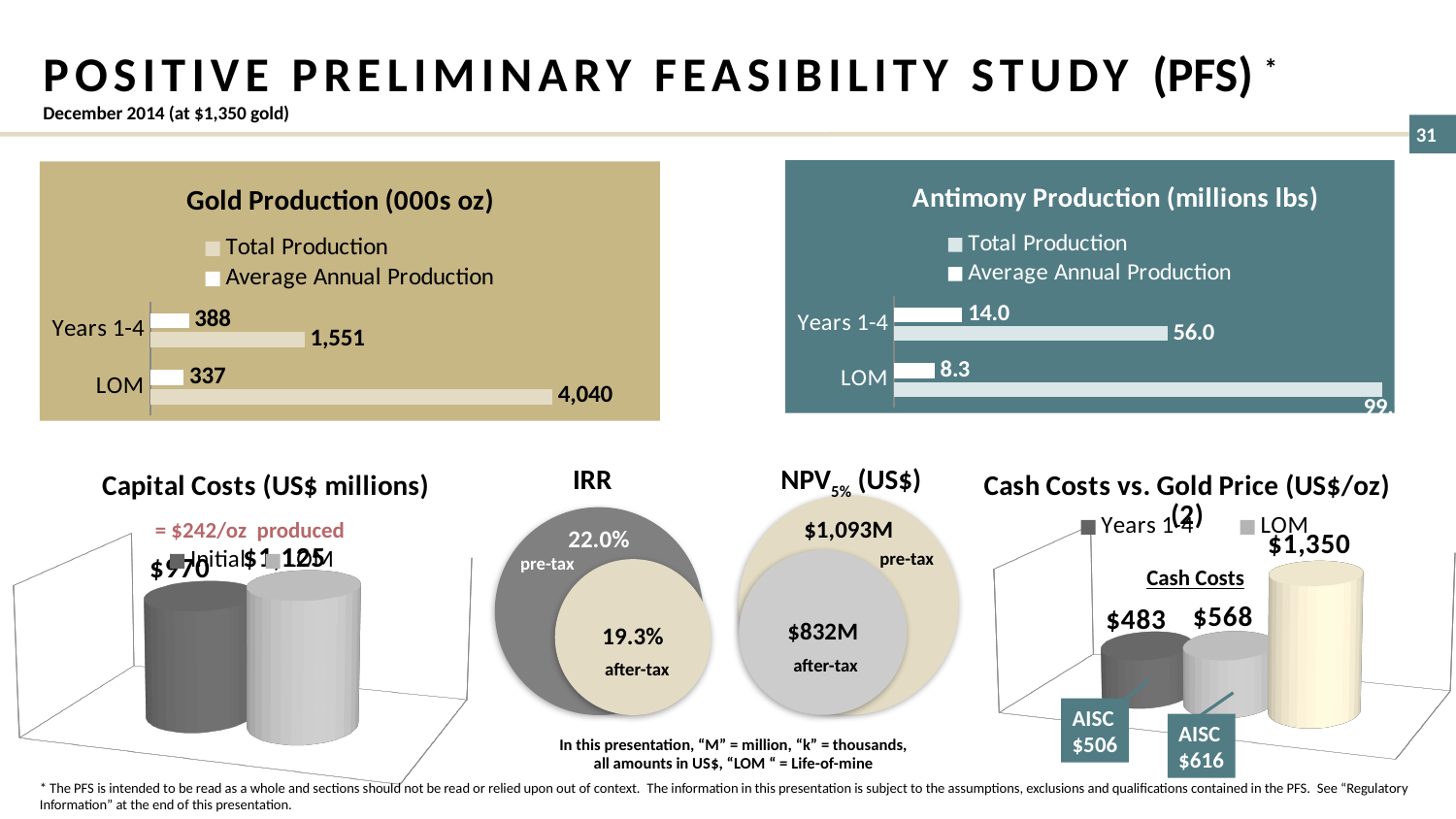
In the Cash Costs vs. Gold Price (US$/oz) chart, what is the LOM cash cost? $568 In the Antimony Production (millions lbs) chart, what is the difference between Average Annual Production for Years 1-4 and for LOM? 5.7 In the Antimony Production (millions lbs) chart, what is the Total Production value for Years 1-4? 56.0 In the IRR chart, what is the after-tax IRR? 19.3% In the Gold Production (000s oz) chart, what is the difference between Total Production for LOM and Total Production for Years 1-4? 2,489 In the NPV5% (US$) chart, what is the pre-tax NPV? $1,093M What kind of chart is the Antimony Production (millions lbs) chart? Bar chart In the Antimony Production (millions lbs) chart, what is the Average Annual Production value for LOM? 8.3 In the Gold Production (000s oz) chart, what is the Average Annual Production value for Years 1-4? 388 In the Gold Production (000s oz) chart, which category has the higher Average Annual Production, Years 1-4 or LOM? Years 1-4 How many series does the legend of the Gold Production (000s oz) chart list? 2 In the Gold Production (000s oz) chart, what is the Total Production value for LOM? 4,040